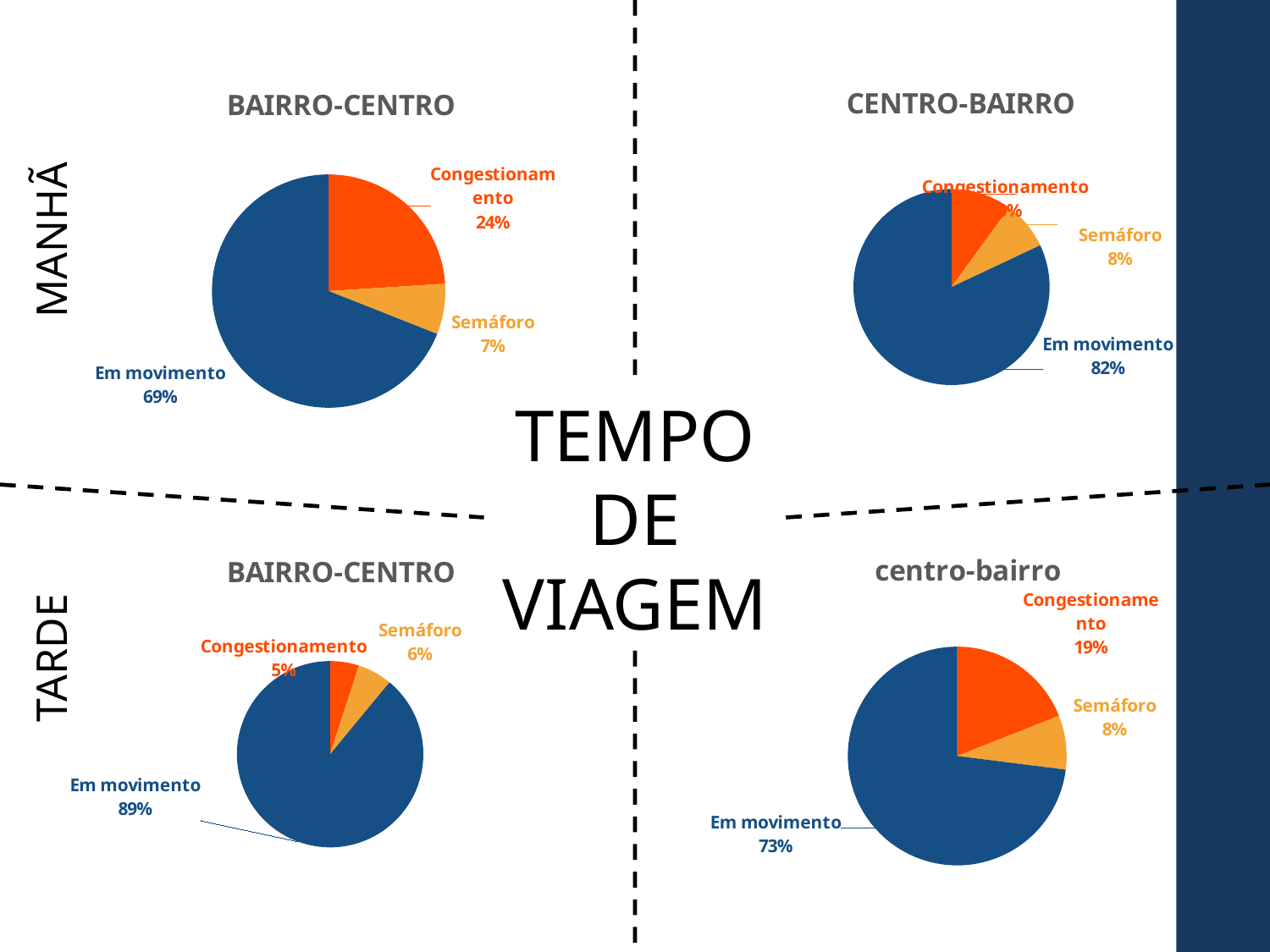
How many pie charts are shown on the slide? 4 In the bottom-left pie chart (BAIRRO-CENTRO, Tarde), what share is labelled for Em movimento? 89% In the bottom-right pie chart (centro-bairro, Tarde), what share is labelled for Congestionamento? 19% In the top-right pie chart (CENTRO-BAIRRO, Manhã), what share is labelled for Semáforo? 8% In the bottom-right pie chart (centro-bairro, Tarde), which category has the largest slice? Em movimento In the top-right pie chart (CENTRO-BAIRRO, Manhã), what share is labelled for Em movimento? 82% In the top-left pie chart (BAIRRO-CENTRO, Manhã), what share is labelled for Em movimento? 69% In the top-left pie chart (BAIRRO-CENTRO, Manhã), what share is labelled for Semáforo? 7% In the top-left pie chart (BAIRRO-CENTRO, Manhã), what is the difference between the Congestionamento share and the Semáforo share? 17% In the top-left pie chart (BAIRRO-CENTRO, Manhã), what share is labelled for Congestionamento? 24% In the top-left pie chart (BAIRRO-CENTRO, Manhã), which category has the smallest slice? Semáforo In the bottom-left pie chart (BAIRRO-CENTRO, Tarde), what share is labelled for Congestionamento? 5%